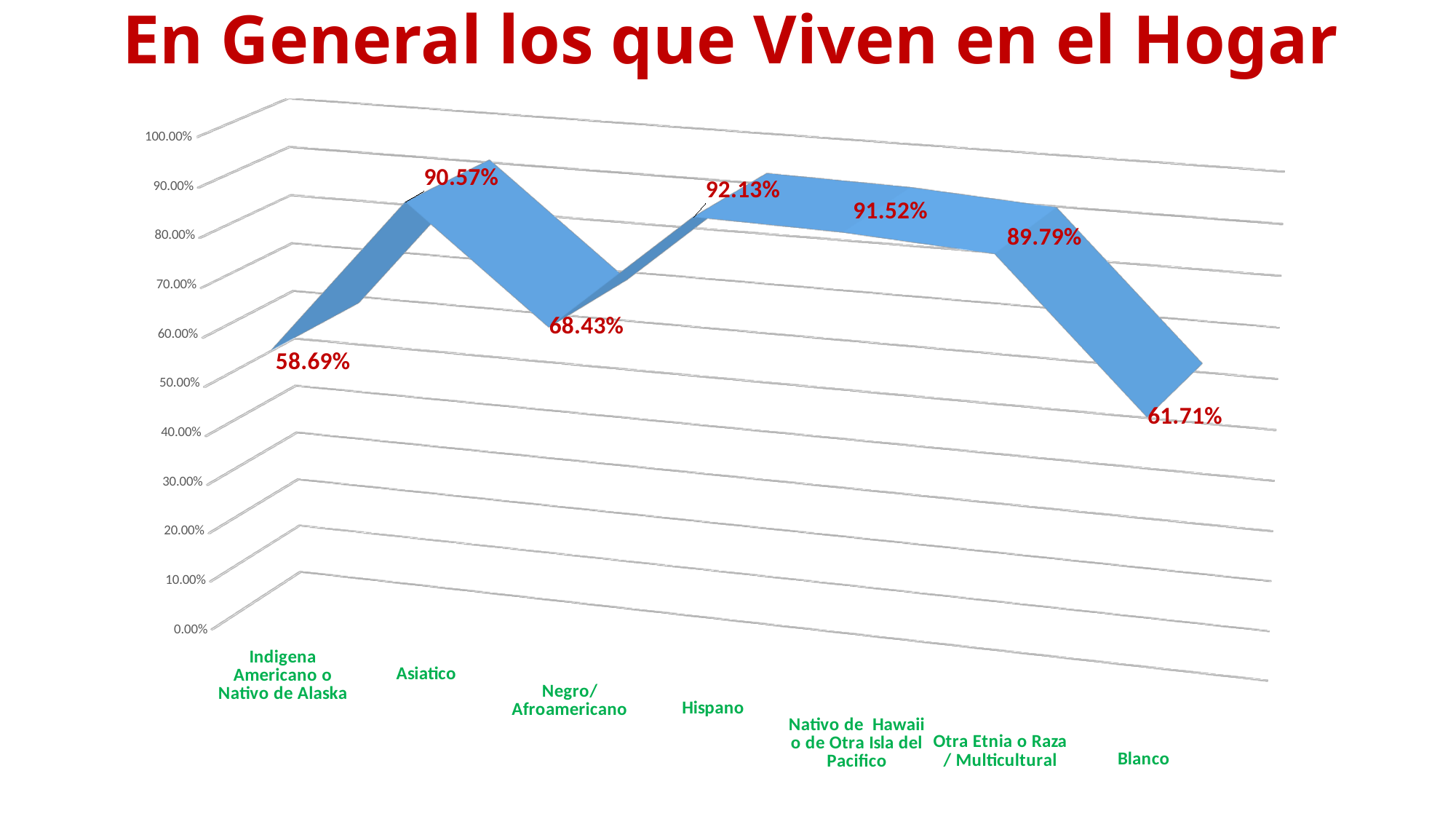
What is the difference between the values for Asiatico and Negro/Afroamericano? 22.14 percentage points What is the value for Blanco? 61.71% What kind of chart is shown on the slide? 3D line chart What is the value for Hispano? 92.13% Which category has the lowest value? Indigena Americano o Nativo de Alaska What is the difference between the values for Blanco and Indigena Americano o Nativo de Alaska? 3.02 percentage points What is the value for Indigena Americano o Nativo de Alaska? 58.69% Which is larger, the value for Asiatico or the value for Blanco? Asiatico Which category has the highest value? Hispano What is the title of the chart? En General los que Viven en el Hogar What is the value for Nativo de Hawaii o de Otra Isla del Pacifico? 91.52% How many categories are shown on the x axis? 7